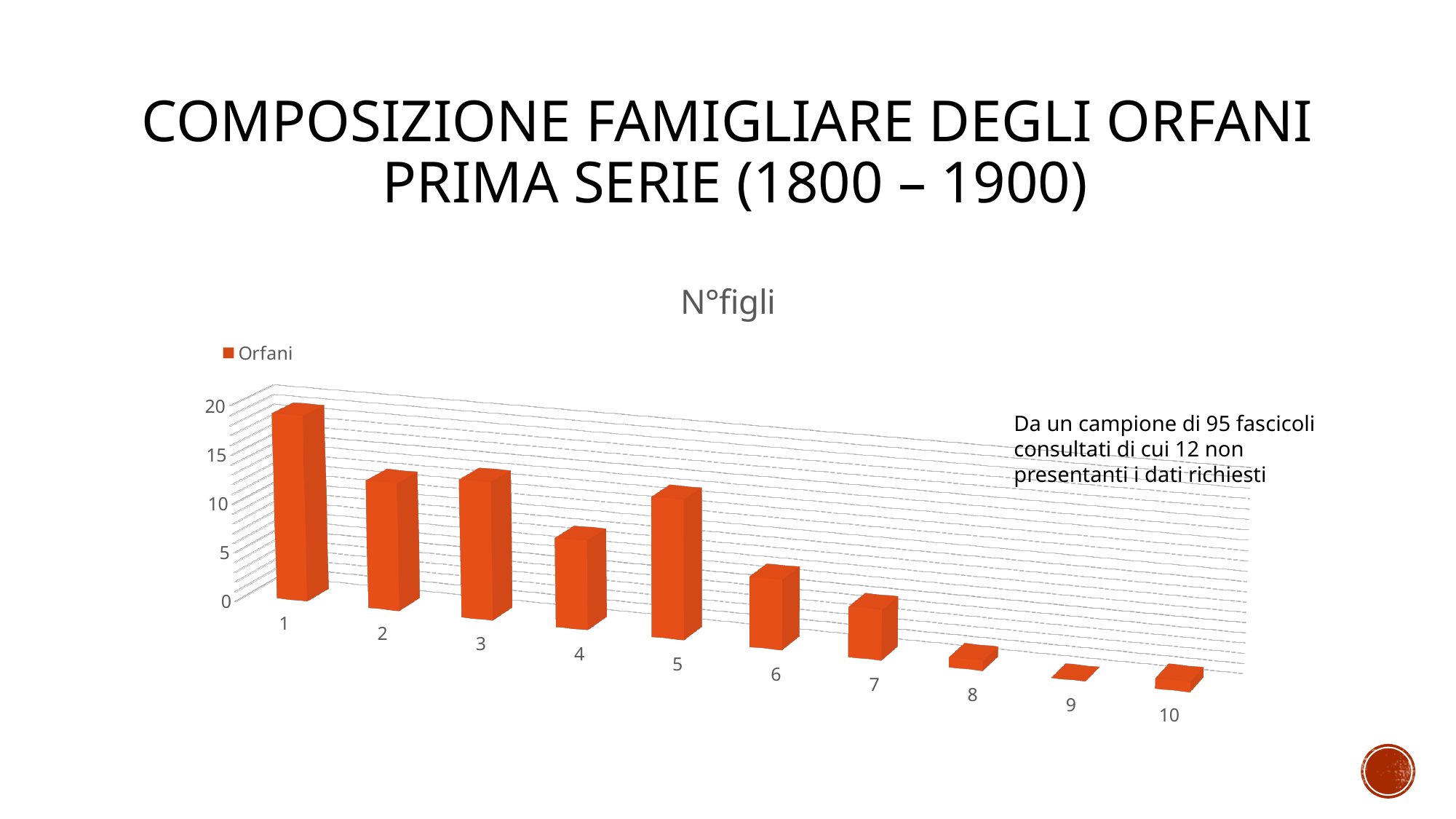
What kind of chart is shown on the slide? bar chart How many categories are shown on the x axis of the chart? 10 Which category has the highest value in the chart? 1 Is the value for category 8 greater or less than 5? less Which is larger, the value for category 1 or the value for category 4? category 1 Is the value for category 1 greater or less than 15? greater Do the values generally rise or fall as the number of children increases from 1 to 10? fall Is the value for category 4 greater or less than 10? less What series name does the chart legend list? Orfani How many series does the legend list? 1 What is the title of the chart? N°figli